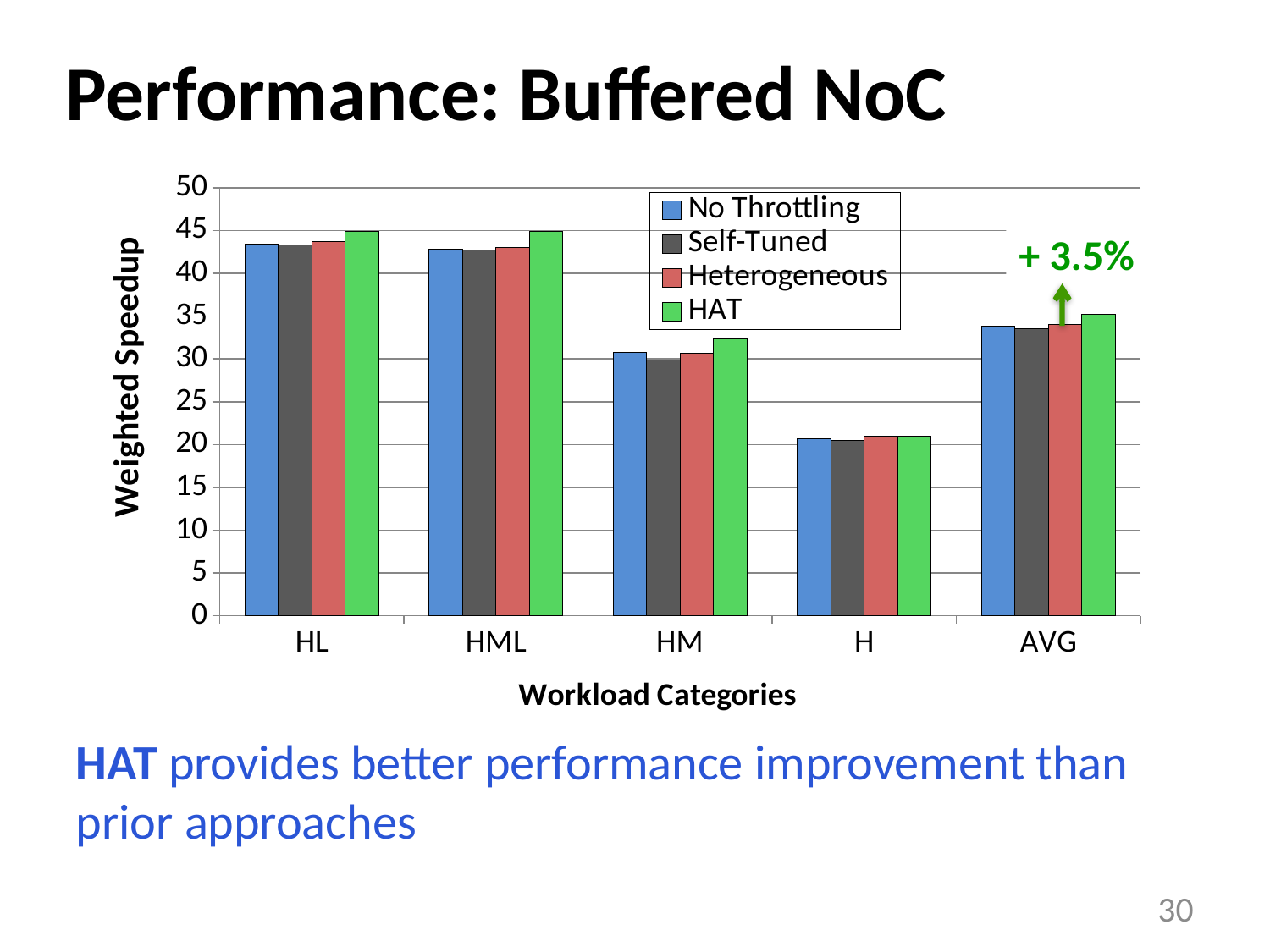
Is the HAT value for HL greater or less than 40? greater What is the label of the y axis? Weighted Speedup How many series does the legend list? 4 Is the No Throttling value for H greater or less than 25? less Which is larger: the No Throttling value for HL or the No Throttling value for H? HL For the HM category, which is larger: the HAT value or the Self-Tuned value? HAT Is the HAT value for HM greater or less than 30? greater How many workload categories are shown on the x axis? 5 What improvement percentage is annotated above the AVG group? + 3.5% What kind of chart is shown on the slide? bar chart Which workload category has the lowest weighted speedup across all series? H